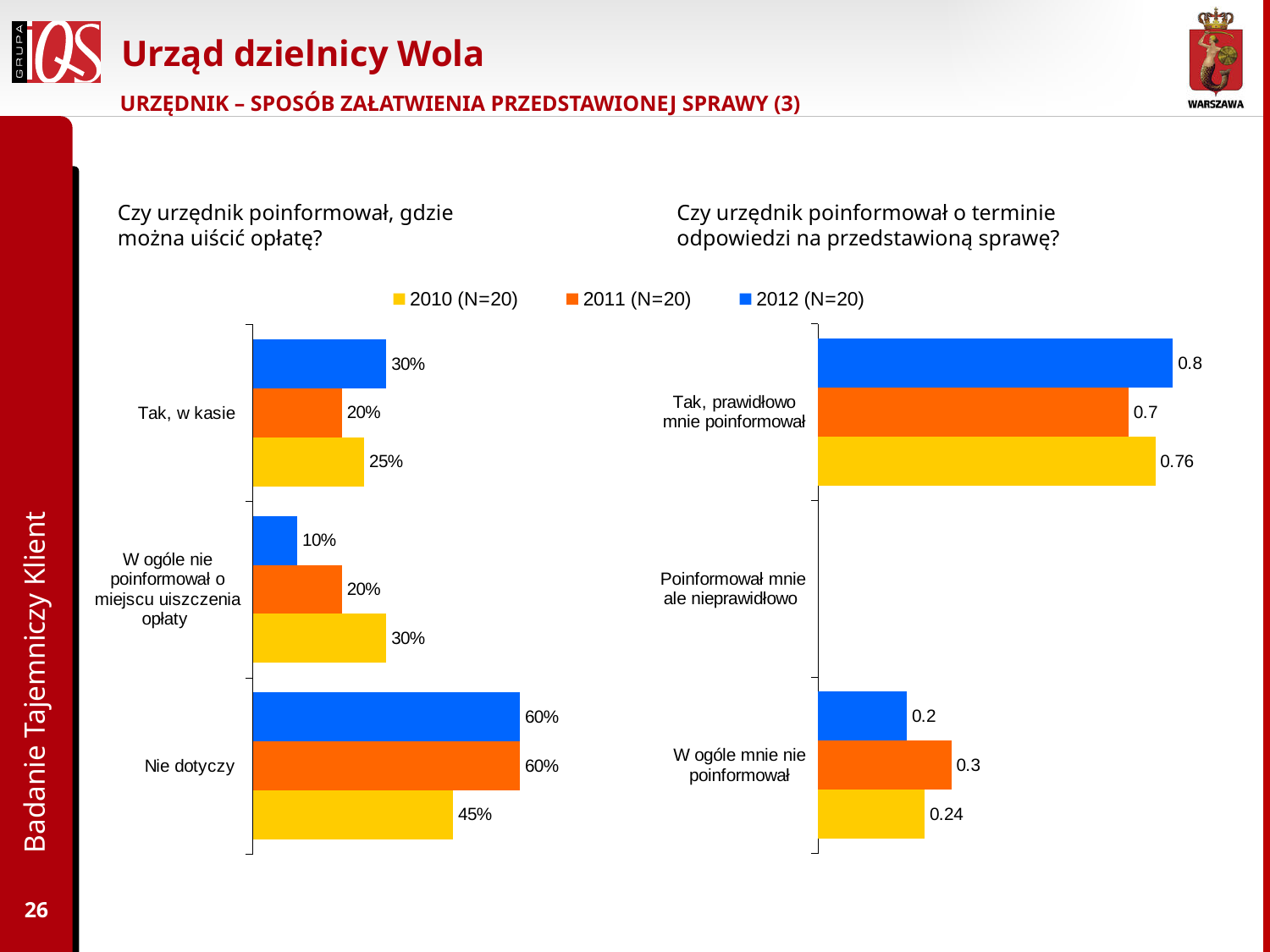
In the left chart ("Czy urzędnik poinformował, gdzie można uiścić opłatę?"), what is the difference between the 2010 and 2012 values for "W ogóle nie poinformował o miejscu uiszczenia opłaty"? 20% In the left chart ("Czy urzędnik poinformował, gdzie można uiścić opłatę?"), what is the value for "Nie dotyczy" in 2010 (N=20)? 45% In the left chart ("Czy urzędnik poinformował, gdzie można uiścić opłatę?"), which is larger for "Tak, w kasie": the 2011 value or the 2010 value? 2010 (25%) How many series does the legend list? 3 In the left chart ("Czy urzędnik poinformował, gdzie można uiścić opłatę?"), which category has the lowest value for 2012 (N=20)? W ogóle nie poinformował o miejscu uiszczenia opłaty In the left chart ("Czy urzędnik poinformował, gdzie można uiścić opłatę?"), what is the value for "Tak, w kasie" in 2012 (N=20)? 30% What kind of chart is the left chart ("Czy urzędnik poinformował, gdzie można uiścić opłatę?")? Bar chart In the right chart ("Czy urzędnik poinformował o terminie odpowiedzi na przedstawioną sprawę?"), what is the difference between the 2011 and 2010 values for "W ogóle mnie nie poinformował"? 0.06 How many categories are shown in the right chart ("Czy urzędnik poinformował o terminie odpowiedzi na przedstawioną sprawę?")? 3 In the right chart ("Czy urzędnik poinformował o terminie odpowiedzi na przedstawioną sprawę?"), what is the value for "W ogóle mnie nie poinformował" in 2011 (N=20)? 0.3 In the right chart ("Czy urzędnik poinformował o terminie odpowiedzi na przedstawioną sprawę?"), which year has the highest value for "Tak, prawidłowo mnie poinformował"? 2012 (N=20) In the right chart ("Czy urzędnik poinformował o terminie odpowiedzi na przedstawioną sprawę?"), what is the value for "Tak, prawidłowo mnie poinformował" in 2012 (N=20)? 0.8